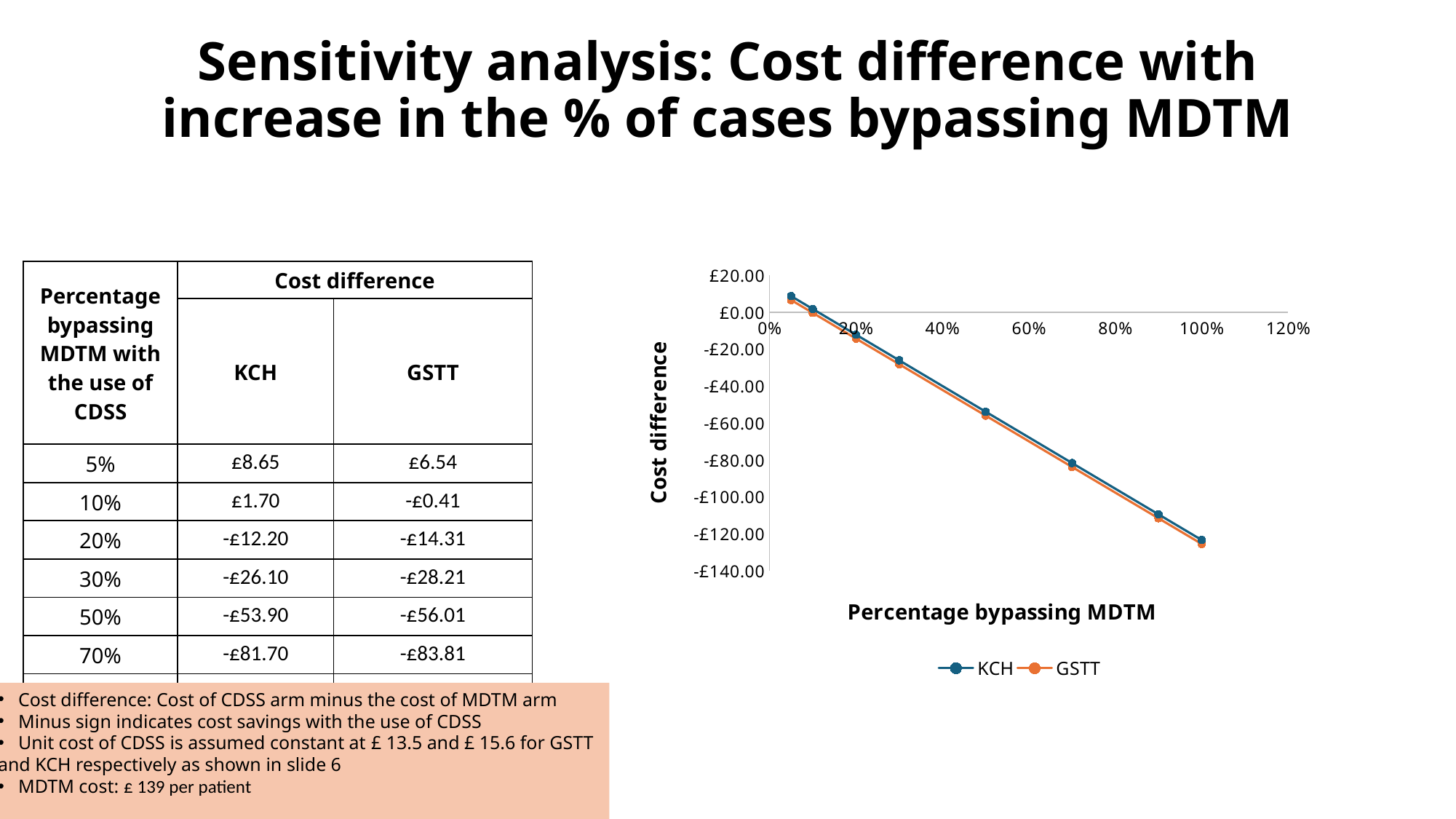
What is the difference between the KCH and GSTT cost differences at 5% bypassing MDTM? £2.11 How many data points are plotted for the KCH series? 8 Which two series are listed in the chart legend? KCH and GSTT Do the cost difference values rise or fall as the percentage bypassing MDTM increases? fall Is the KCH cost difference at 90% bypassing MDTM greater or less than -£100.00? less What is the title of the chart's x axis? Percentage bypassing MDTM What kind of chart is shown on the slide? line chart At which percentage bypassing MDTM is the KCH cost difference highest? 5% How many series does the chart legend list? 2 At 50% bypassing MDTM, which series has the larger cost difference, KCH or GSTT? KCH What is the cost difference for GSTT at 50% bypassing MDTM? -£56.01 What is the cost difference for KCH at 5% bypassing MDTM? £8.65